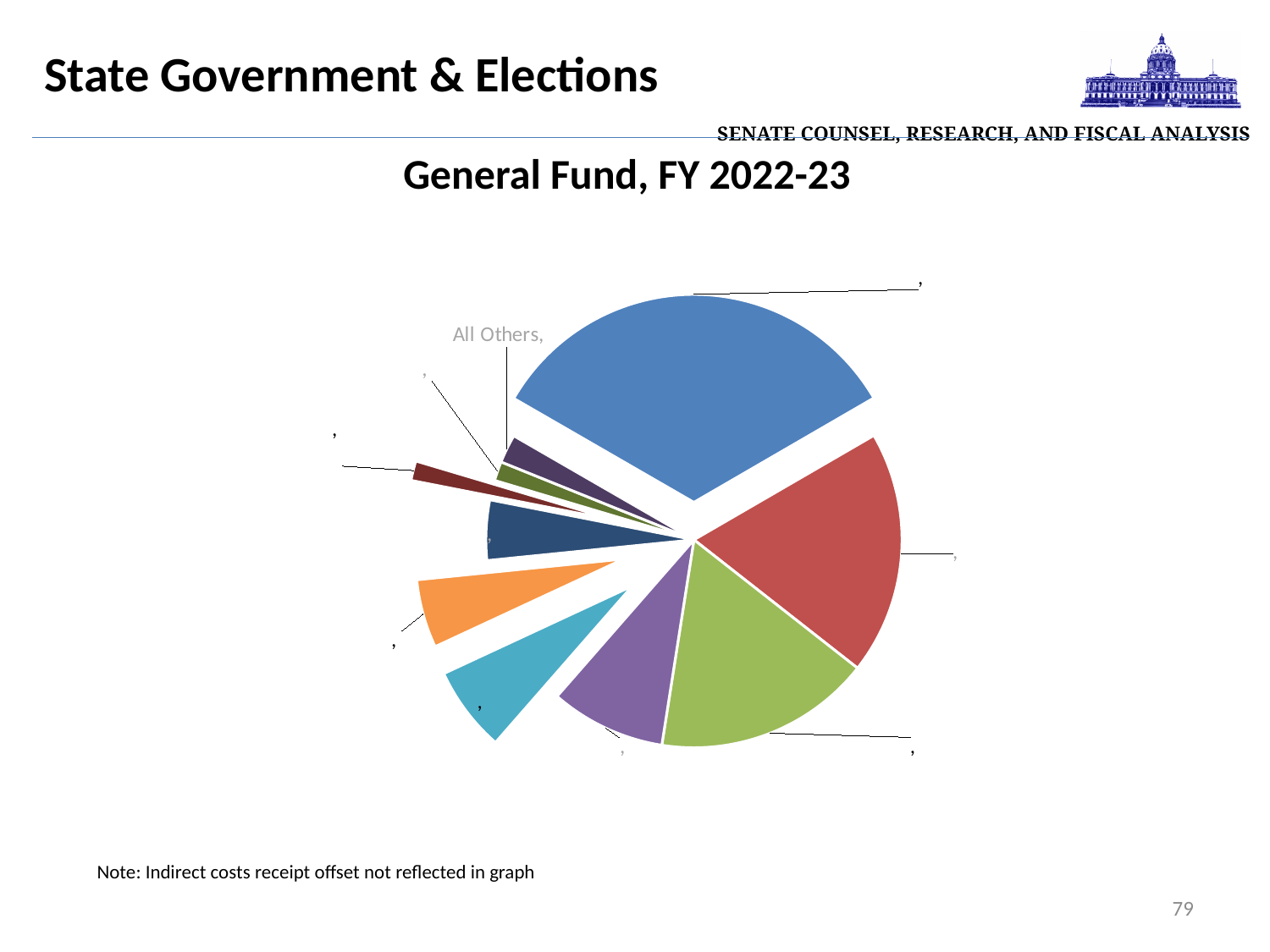
What does the note below the chart say? Note: Indirect costs receipt offset not reflected in graph What kind of chart is shown on the slide? pie chart Which colour slice is the largest in the pie chart? blue Which is larger, the blue slice or the red slice? the blue slice Which is larger, the blue slice or the orange slice? the blue slice What is the title of the chart? General Fund, FY 2022-23 How many slices does the pie chart have? 10 Which is larger, the red slice or the orange slice? the red slice